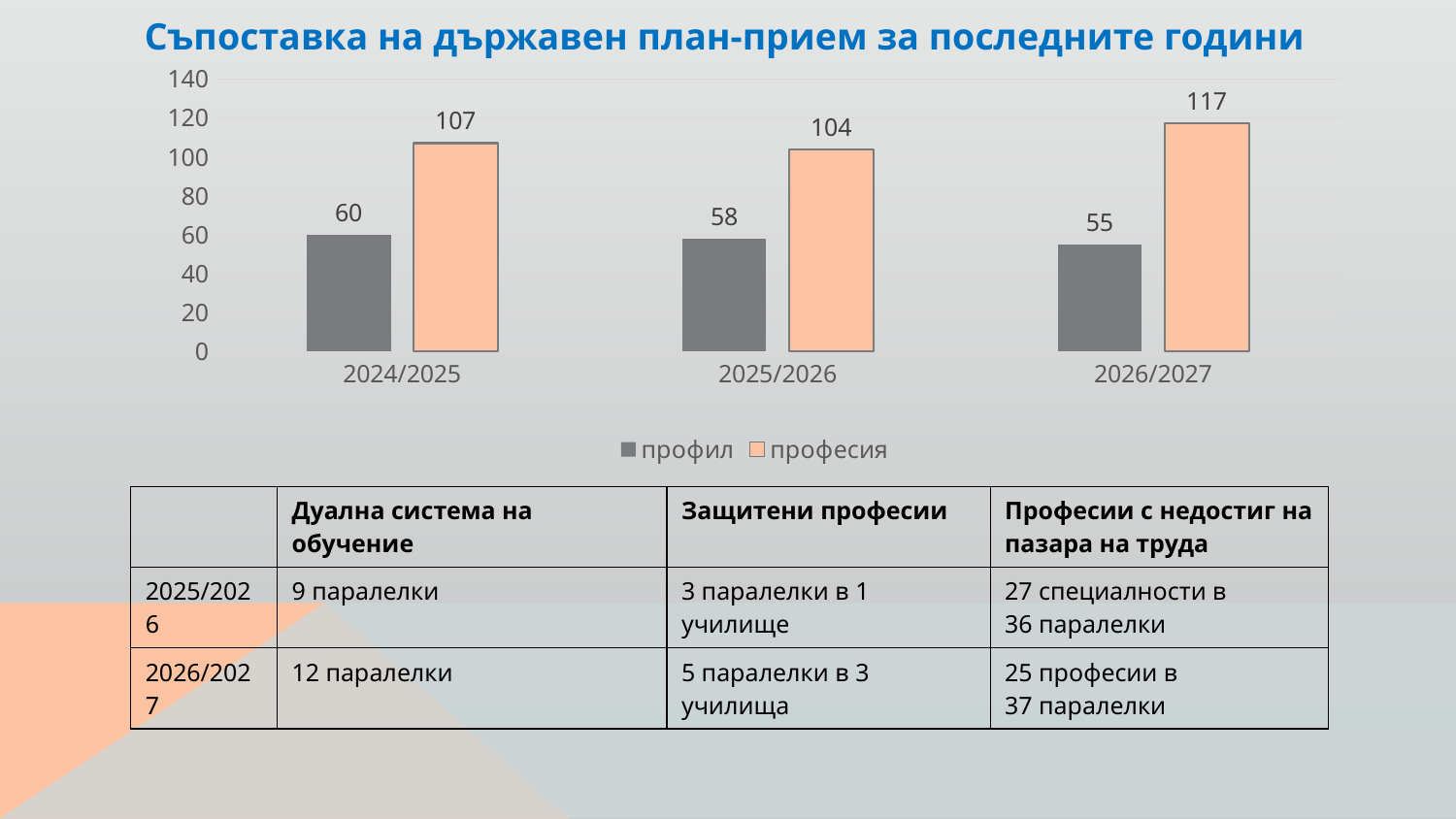
Is the value for професия in 2026/2027 greater or less than 100? greater What is the value for професия in 2026/2027? 117 How many years are shown on the x axis? 3 Which is larger in 2025/2026, профил or професия? професия What kind of chart is shown? bar chart What is the value for профил in 2024/2025? 60 What is the difference between професия and профил in 2024/2025? 47 How many series does the legend list? 2 Does the value for профил rise or fall from 2024/2025 to 2026/2027? fall Which year has the lowest value for профил? 2026/2027 What is the value for професия in 2025/2026? 104 Which year has the highest value for професия? 2026/2027